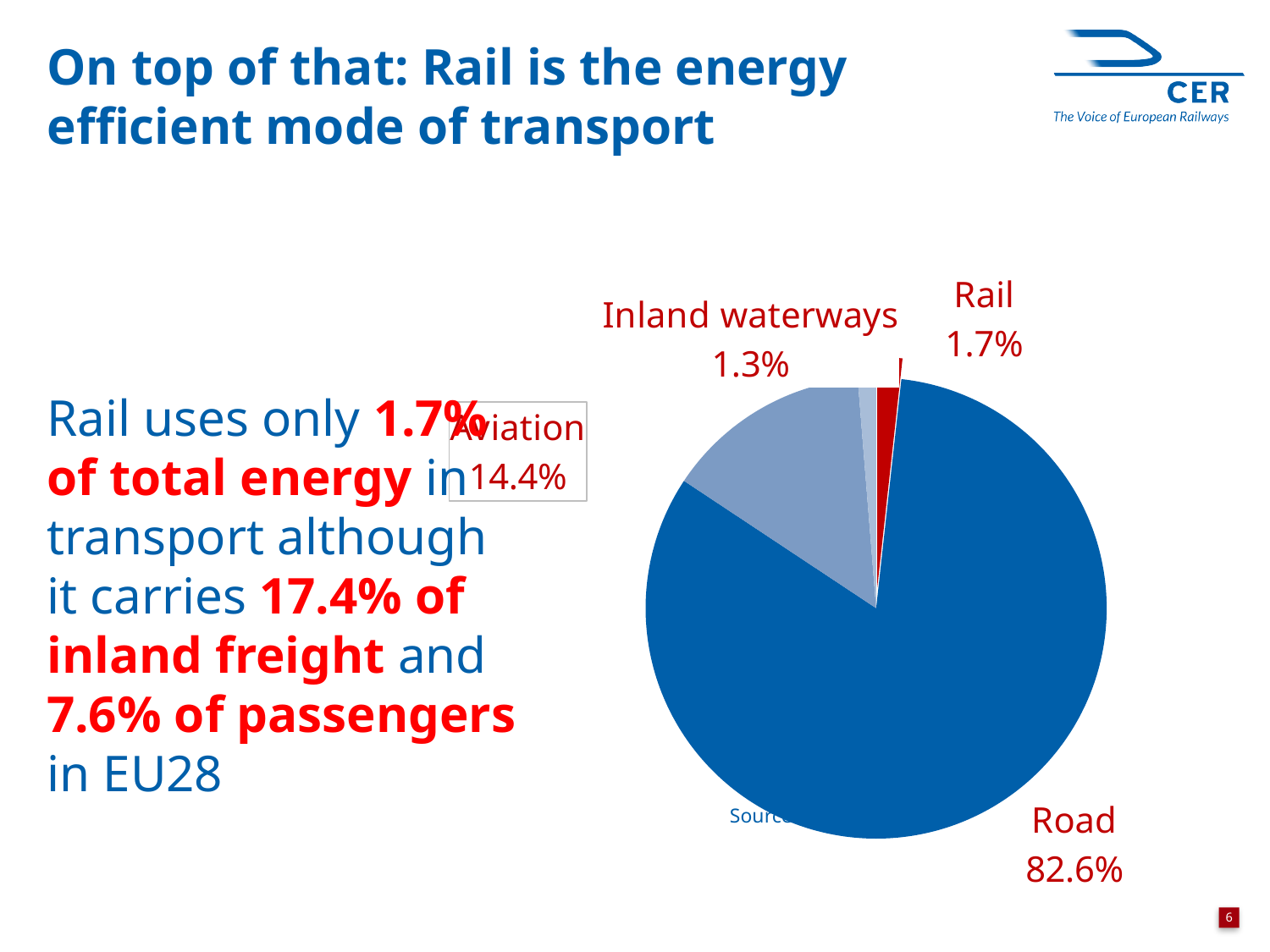
Which mode of transport has the largest slice of the pie? Road What kind of chart is shown on the slide? pie chart What share of the pie does Aviation account for? 14.4% What is the difference in percentage points between the Rail and Inland waterways slices? 0.4 What colour is the Rail slice of the pie? red Which mode of transport has the smallest slice of the pie? Inland waterways Which slice is larger, Aviation or Rail? Aviation What share of the pie does Inland waterways account for? 1.3% What share of the pie does Rail account for? 1.7% What share of the pie does Road account for? 82.6% What is the difference in percentage points between the Road and Aviation slices? 68.2 How many slices does the pie chart have? 4